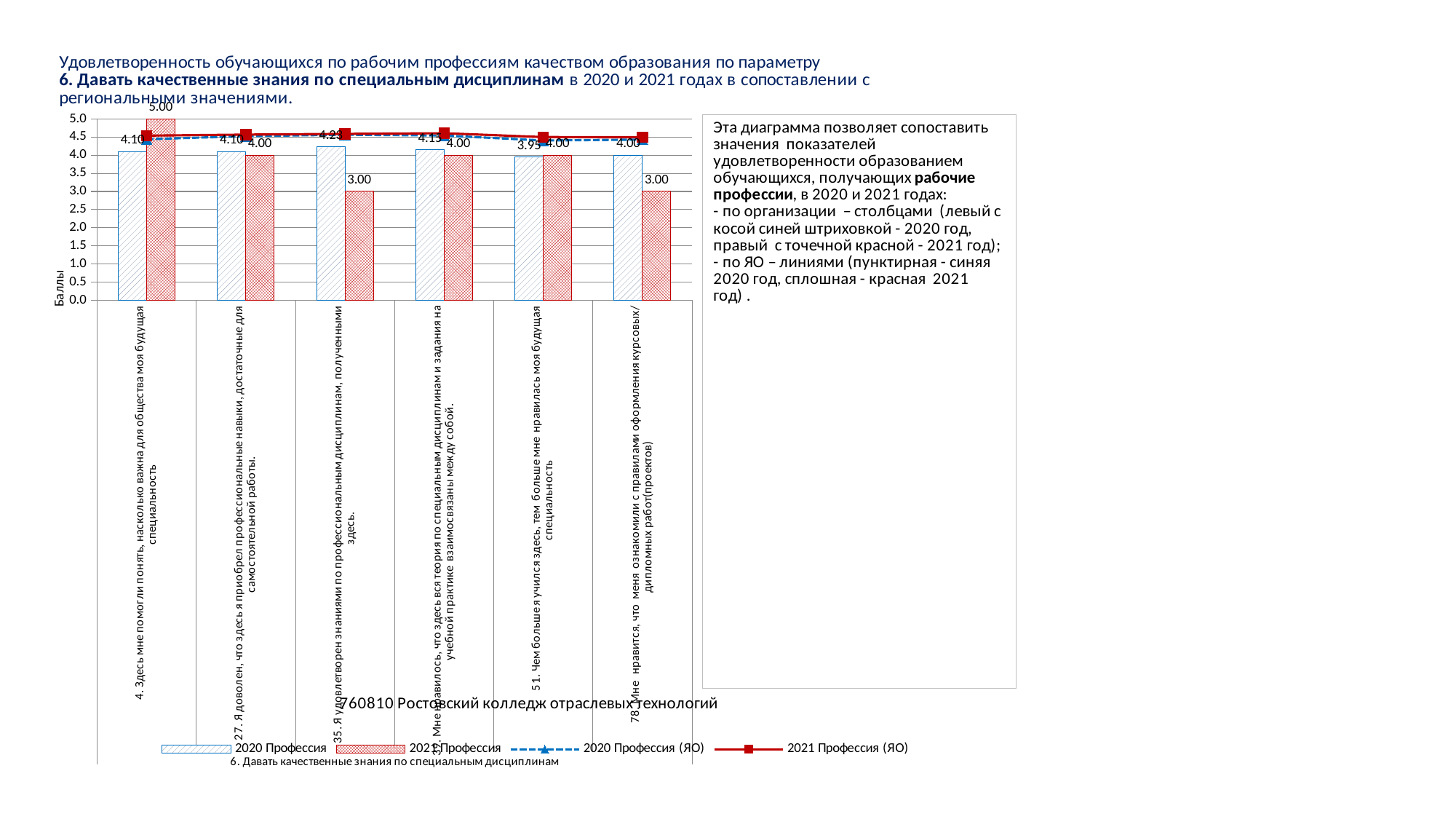
How many series does the legend list? 4 What is the difference between the 2021 and 2020 Профессия values for category "4. Здесь мне помогли понять, насколько важна для общества моя будущая специальность"? 0.90 Which category has the highest 2021 Профессия bar? 4. Здесь мне помогли понять, насколько важна для общества моя будущая специальность What is the 2021 Профессия value for category "4. Здесь мне помогли понять, насколько важна для общества моя будущая специальность"? 5.00 How many categories (questions) are plotted along the x axis? 6 What is the difference between the 2020 and 2021 Профессия values for category "78. Мне нравится, что меня ознакомили с правилами оформления курсовых/дипломных работ(проектов)"? 1.00 What is the 2021 Профессия value for category "35. Я удовлетворен знаниями по профессиональным дисциплинам, полученными здесь"? 3.00 Is the 2021 Профессия (ЯО) line value for category "4. Здесь мне помогли понять, насколько важна для общества моя будущая специальность" greater or less than 4.0? greater What kind of chart is shown on the slide? Combined bar and line chart What is the title of the vertical axis? Баллы What is the 2020 Профессия value for category "51. Чем больше я учился здесь, тем больше мне нравилась моя будущая специальность"? 3.95 For category "78. Мне нравится, что меня ознакомили с правилами оформления курсовых/дипломных работ(проектов)", which is larger: the 2020 Профессия value or the 2021 Профессия value? 2020 Профессия